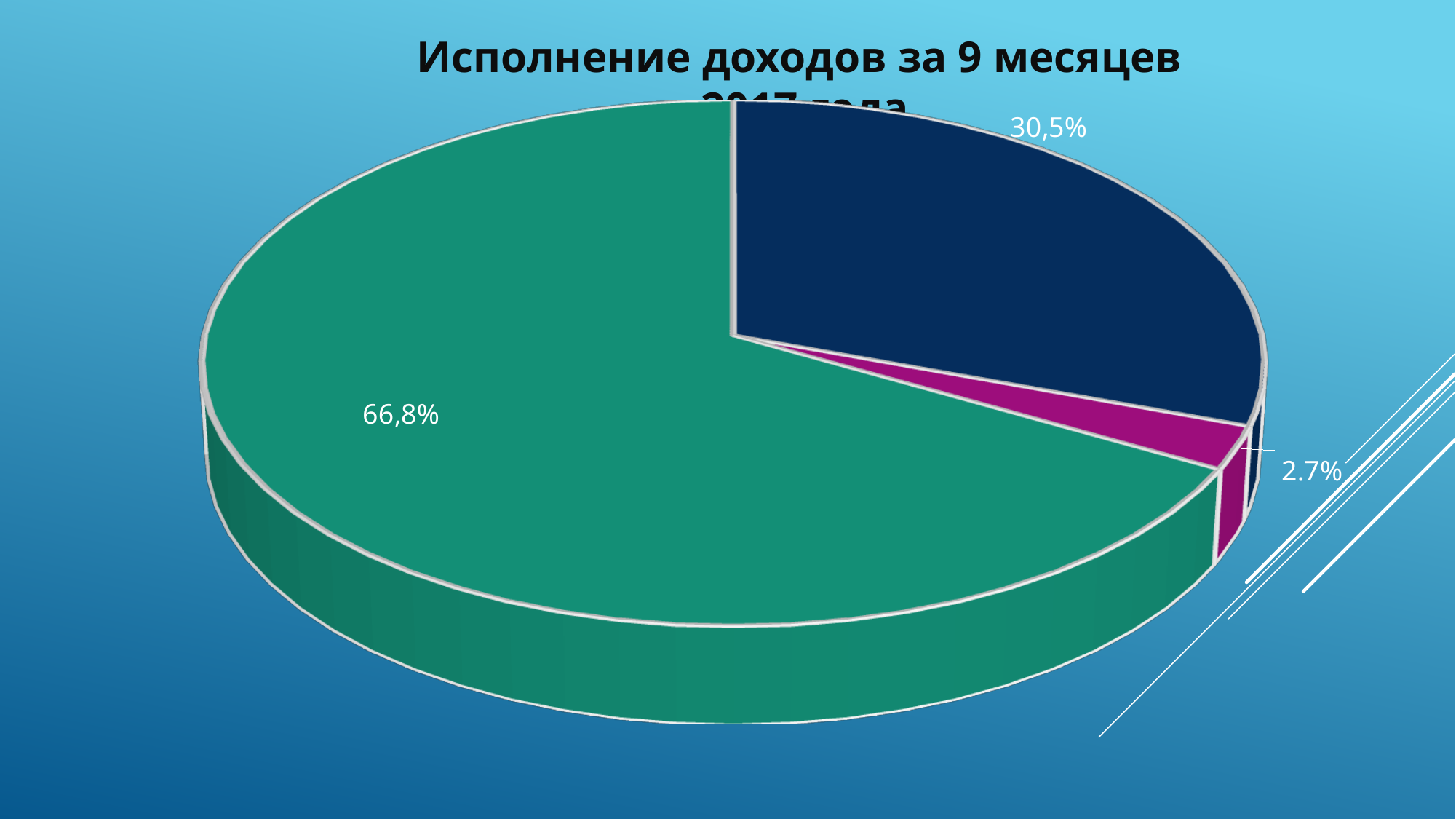
What is the value shown for the dark blue slice of the pie chart? 30,5% By how many percentage points does the green slice exceed the dark blue slice? 36,3 What colour is the largest slice of the pie chart? Green What is the value of the smallest slice in the pie chart? 2.7% Which slice is larger, the green one or the dark blue one? The green one What is the value shown for the magenta slice of the pie chart? 2.7% What is the title of the chart? Исполнение доходов за 9 месяцев 2017 года How many slices does the pie chart have? 3 What kind of chart is shown on the slide? Pie chart What is the value shown for the green slice of the pie chart? 66,8% By how many percentage points does the dark blue slice exceed the magenta slice? 27,8 What is the value of the largest slice in the pie chart? 66,8%